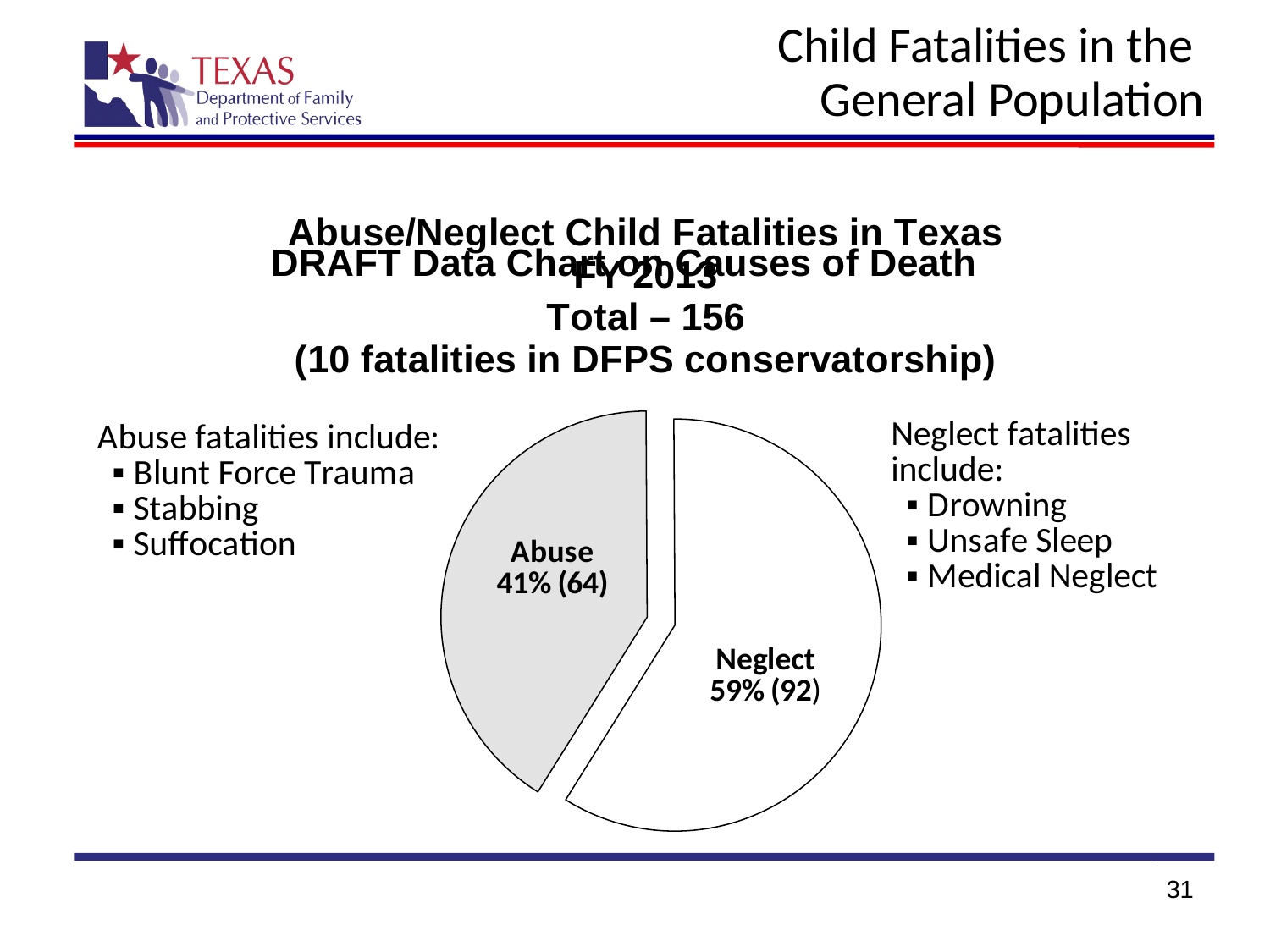
Which slice of the pie chart is shaded grey? Abuse What percentage of the pie does the Neglect slice represent? 59% What is the difference between the Neglect count and the Abuse count? 28 Which slice of the pie is the smallest? Abuse How many slices does the pie chart have? 2 How many fatalities are shown for the Neglect slice? 92 Which is larger, the Abuse count or the Neglect count? Neglect What is the total number of fatalities shown in the pie chart? 156 How many fatalities are shown for the Abuse slice? 64 What percentage of the pie does the Abuse slice represent? 41% Which slice of the pie is the largest? Neglect What kind of chart is shown on the slide? pie chart